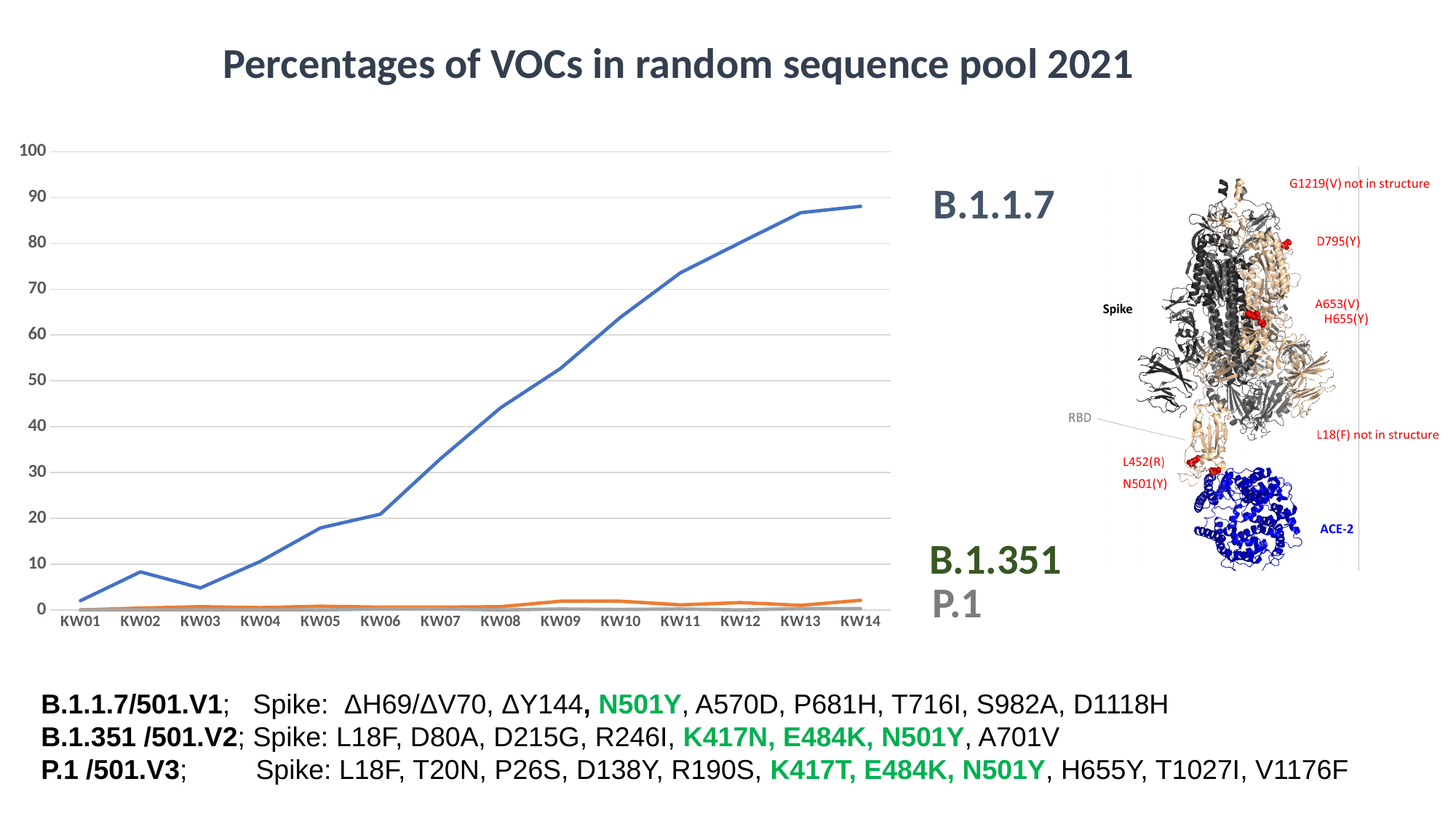
How many calendar weeks (KW) are shown on the x axis of the chart? 14 Does the blue line (B.1.1.7) rise or fall from KW01 to KW14? rise Is the value of the blue line (B.1.1.7) at KW05 greater or less than 20? less Is the value of the blue line (B.1.1.7) at KW11 greater or less than 70? greater What is the title of the chart? Percentages of VOCs in random sequence pool 2021 At which week is the blue line (B.1.1.7) at its lowest value? KW01 What kind of chart is shown on the slide? line chart Is the value of the blue line (B.1.1.7) at KW14 greater or less than 80? greater At which week does the blue line (B.1.1.7) reach its highest value? KW14 Which is larger for the blue line (B.1.1.7): the value at KW08 or the value at KW03? KW08 How many lines are plotted in the chart? 3